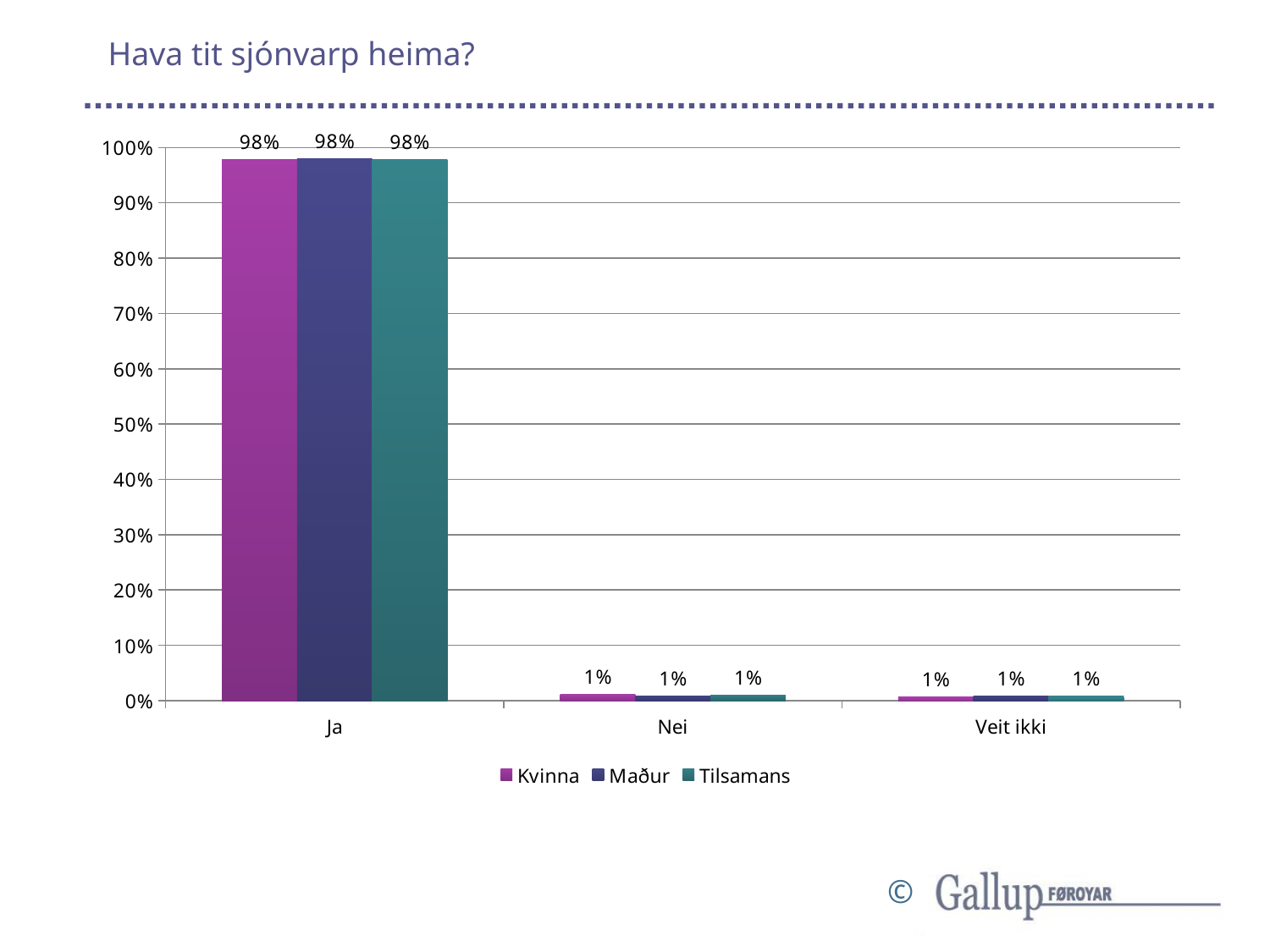
What is the difference between the Kvinna value for Ja and the Kvinna value for Nei? 97% What is the value for Tilsamans in the Veit ikki category? 1% How many series does the legend list? 3 Which is larger: the Maður value for Ja or the Maður value for Veit ikki? Ja What is the value for Maður in the Nei category? 1% What is the value for Kvinna in the Ja category? 98% Which category has the highest value for Tilsamans? Ja How many categories are shown on the x axis? 3 Which series is shown in purple/magenta in the legend? Kvinna What kind of chart is shown on the slide? bar chart What is the title of the slide? Hava tit sjónvarp heima? Is the value for Tilsamans in the Ja category greater or less than 90%? greater